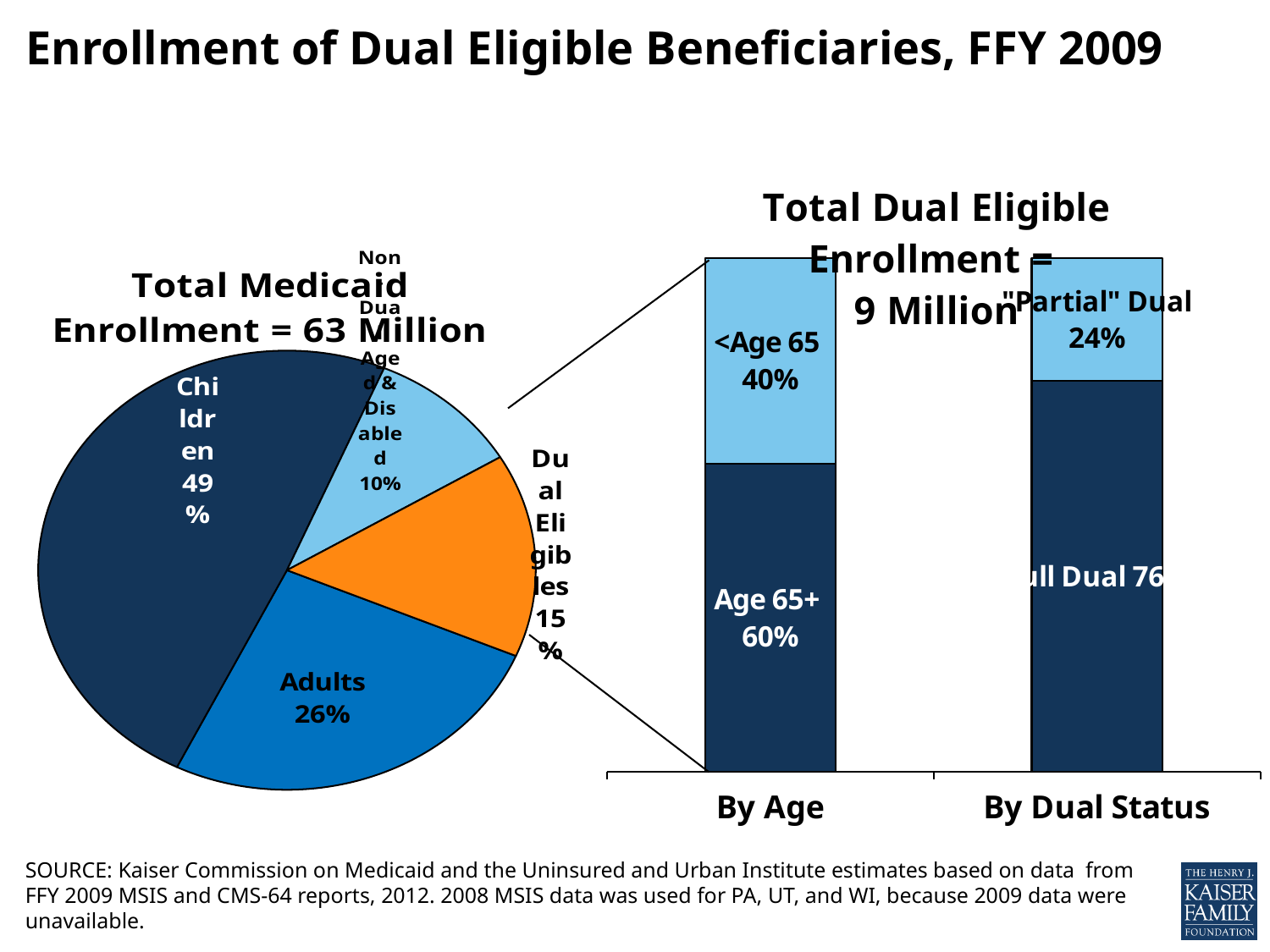
In the pie chart titled 'Total Medicaid Enrollment = 63 Million', which group has the largest share? Children In the bar chart titled 'Total Dual Eligible Enrollment = 9 Million', which is larger in the By Dual Status bar: Full Dual or 'Partial' Dual? Full Dual In the pie chart titled 'Total Medicaid Enrollment = 63 Million', which group has the smallest share? Non-Dual Aged & Disabled In the bar chart titled 'Total Dual Eligible Enrollment = 9 Million', what percentage of dual eligibles are Age 65+? 60% In the pie chart titled 'Total Medicaid Enrollment = 63 Million', how many percentage points larger is the Children share than the Adults share? 23 percentage points In the pie chart titled 'Total Medicaid Enrollment = 63 Million', what share of enrollment is Adults? 26% In the bar chart titled 'Total Dual Eligible Enrollment = 9 Million', what percentage of dual eligibles are 'Partial' Duals? 24% What kind of chart is the one titled 'Total Dual Eligible Enrollment = 9 Million'? Stacked bar chart In the pie chart titled 'Total Medicaid Enrollment = 63 Million', what share of enrollment is Dual Eligibles? 15% In the pie chart titled 'Total Medicaid Enrollment = 63 Million', what share of enrollment is Children? 49% In the bar chart titled 'Total Dual Eligible Enrollment = 9 Million', what percentage of dual eligibles are under age 65? 40% How many slices does the pie chart titled 'Total Medicaid Enrollment = 63 Million' have? 4